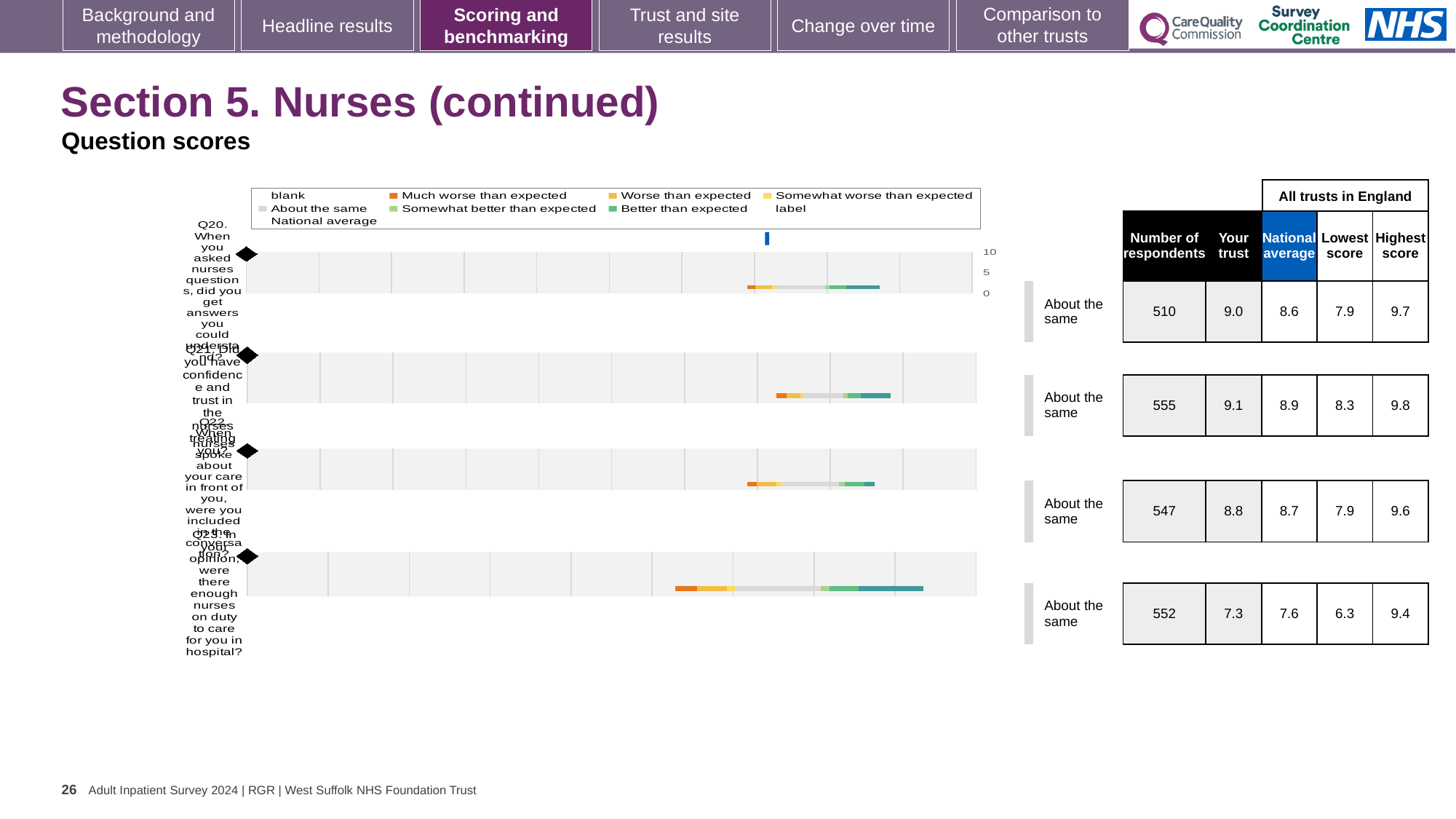
What is the highest score among all trusts in England for Q21? 9.8 What kind of chart is shown on the slide? bar chart What is the lowest score among all trusts in England for Q23 (were there enough nurses on duty to care for you in hospital?)? 6.3 Which question has the highest 'Your trust' score? Q21 How many respondents answered Q22 (When nurses spoke about your care in front of you, were you included in the conversation?)? 547 What is the difference between the 'Your trust' score and the national average for Q20? 0.4 What benchmark category is shown for all four questions on the slide? About the same What is the national average for Q21 (Did you have confidence and trust in the nurses treating you?)? 8.9 For Q23, which is larger: the 'Your trust' score or the national average? National average How many questions (categories) are plotted in the chart? 4 What is the 'Your trust' score for Q20 (When you asked nurses questions, did you get answers you could understand?)? 9.0 Which question has the lowest 'Your trust' score? Q23